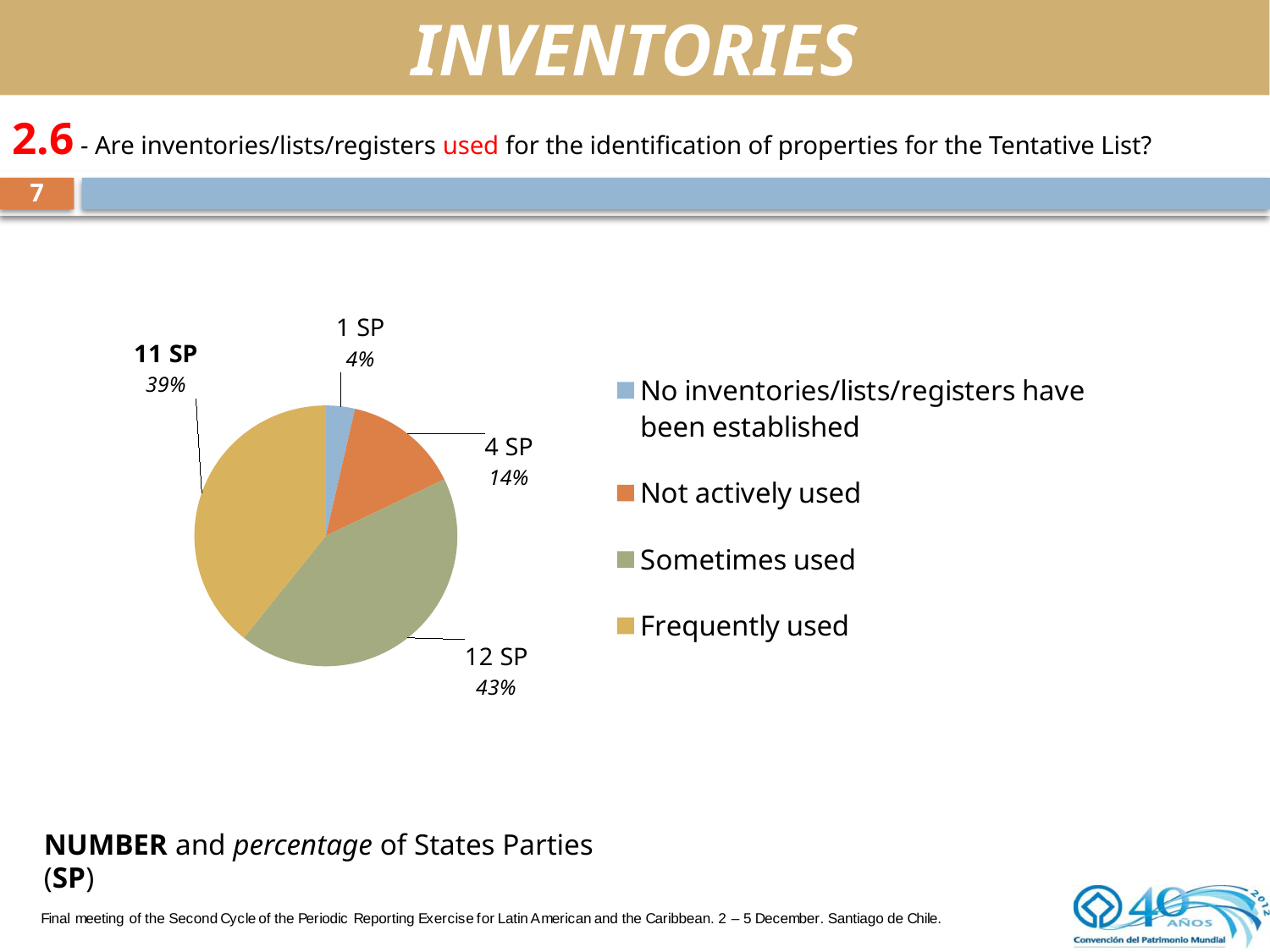
What percentage of States Parties answered "Frequently used"? 39% Which category has the largest share of the pie? Sometimes used Which is larger: the share for "Not actively used" or the share for "Frequently used"? Frequently used What colour is the "Sometimes used" slice in the legend? green How many States Parties answered "Not actively used"? 4 SP What percentage of States Parties have no inventories/lists/registers established? 4% Which category has the smallest share of the pie? No inventories/lists/registers have been established How many States Parties answered "Sometimes used"? 12 SP How many more States Parties answered "Sometimes used" than "Frequently used"? 1 SP How many categories does the pie chart have? 4 What is the total number of States Parties represented in the pie chart? 28 SP What kind of chart is shown on the slide? pie chart